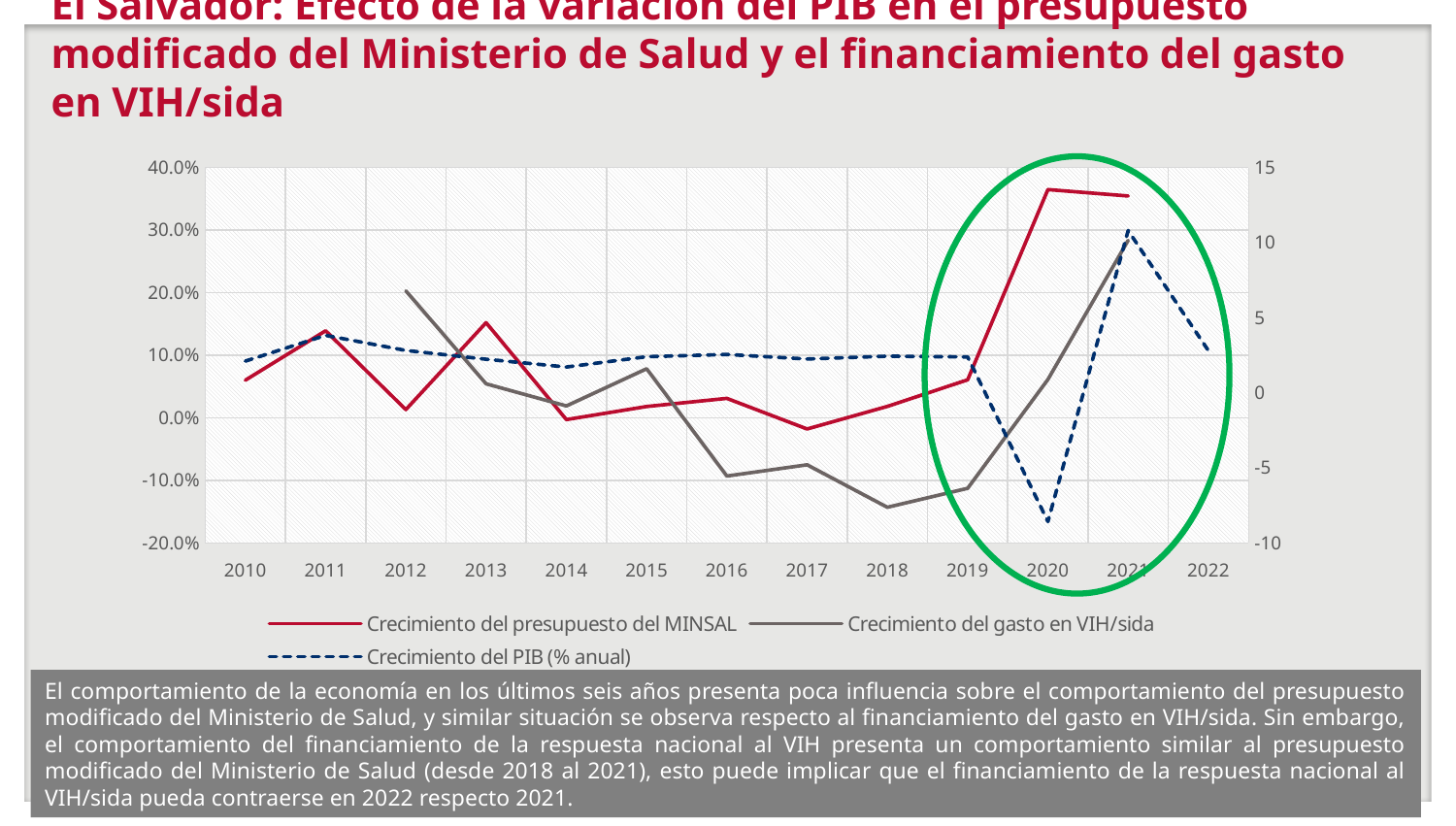
Is the value for Crecimiento del presupuesto del MINSAL in 2020 greater or less than 30.0%? greater How many years are shown on the x axis? 13 How many series does the legend list? 3 What kind of chart is shown on the slide? line chart In which year is the value for Crecimiento del gasto en VIH/sida lowest? 2018 Which series is drawn with a dashed line? Crecimiento del PIB (% anual) Is the value for Crecimiento del PIB (% anual) in 2020 greater or less than -5 on the right axis? less In which year is the value for Crecimiento del PIB (% anual) lowest? 2020 In 2013, which is larger: Crecimiento del presupuesto del MINSAL or Crecimiento del gasto en VIH/sida? Crecimiento del presupuesto del MINSAL Does the value for Crecimiento del gasto en VIH/sida rise or fall from 2018 to 2021? rise Is the value for Crecimiento del gasto en VIH/sida in 2018 greater or less than -10.0%? less In which year is the value for Crecimiento del gasto en VIH/sida highest? 2021